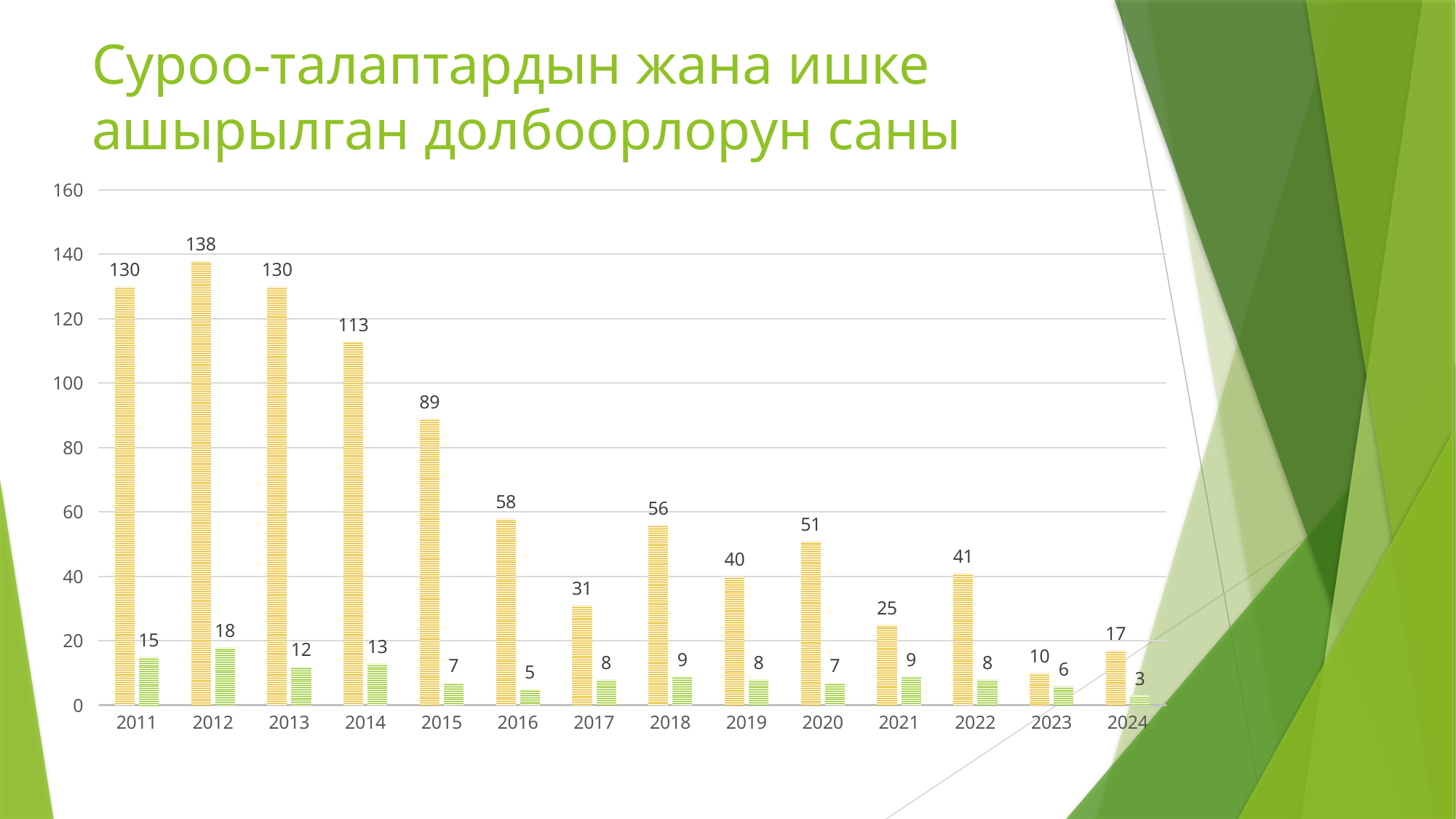
What type of chart is shown on the slide? bar chart What is the value of the green bar for 2021? 9 What is the difference between the orange and green bar values for 2015? 82 How many years are shown on the x axis of the chart? 14 What is the title of the chart on the slide? Суроо-талаптардын жана ишке ашырылган долбоорлорун саны Do the orange bar values generally rise or fall from 2011 to 2024? fall Which year has the lowest green bar? 2024 Which is larger, the orange bar for 2017 or the orange bar for 2018? 2018 What is the value of the orange bar for 2014? 113 What is the difference between the orange bar values for 2012 and 2013? 8 Which year has the highest orange bar? 2012 Is the orange bar value for 2016 greater or less than 60? less